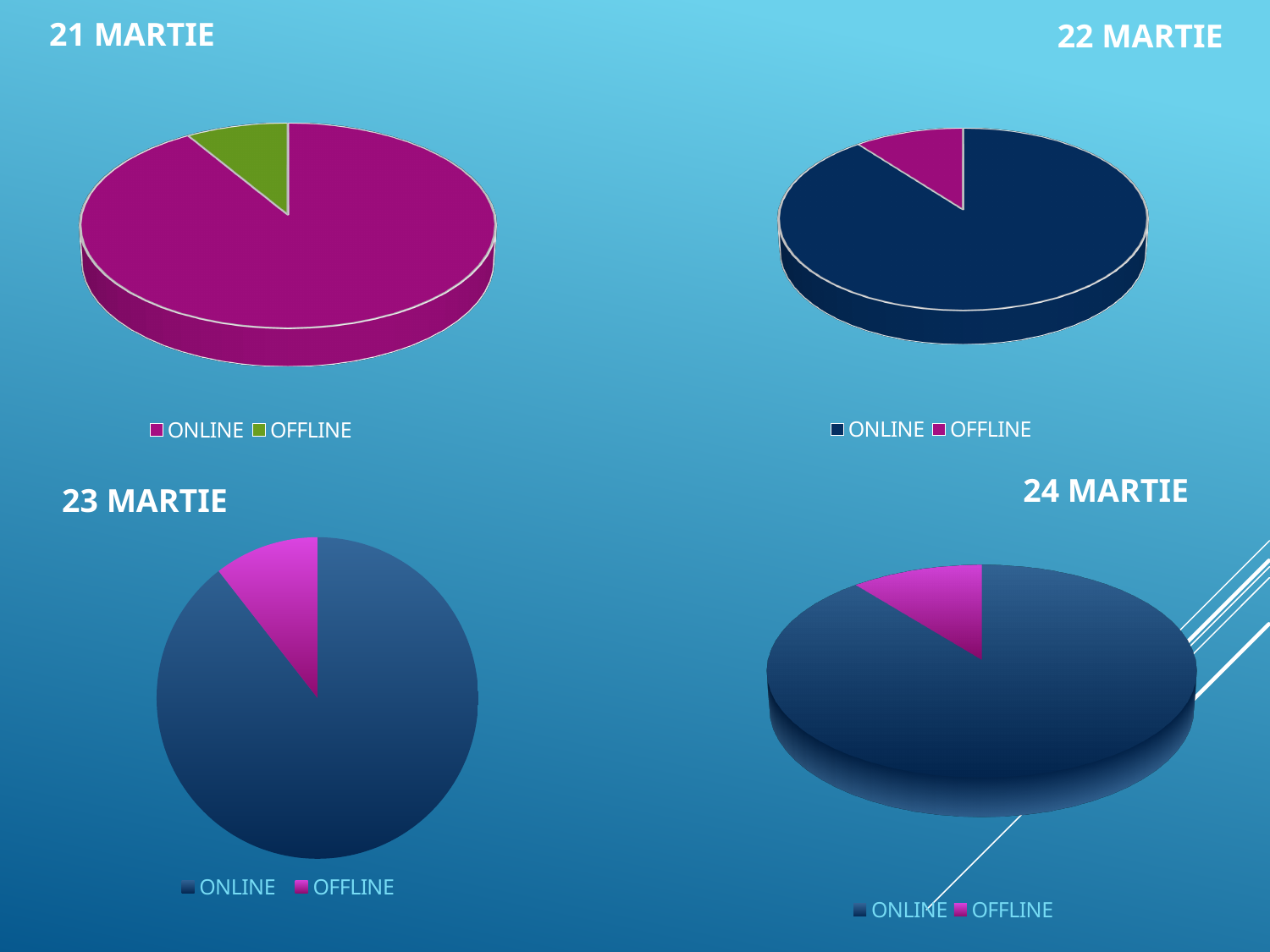
In the '24 MARTIE' chart, which is larger, OFFLINE or ONLINE? ONLINE In the '22 MARTIE' chart, which is larger, ONLINE or OFFLINE? ONLINE In the '21 MARTIE' chart, which category has the largest slice? ONLINE In the '21 MARTIE' chart, what colour is the OFFLINE slice? Green How many slices does the '23 MARTIE' pie chart have? 2 How many categories does the legend of the '22 MARTIE' chart list? 2 In the '21 MARTIE' chart, which category has the smallest slice? OFFLINE In the '24 MARTIE' chart, which category has the smallest slice? OFFLINE How many pie charts are shown on the slide? 4 In the '23 MARTIE' chart, which category has the largest slice? ONLINE What kind of chart is the '21 MARTIE' chart? Pie chart What is the title of the chart in the bottom-left of the slide? 23 MARTIE